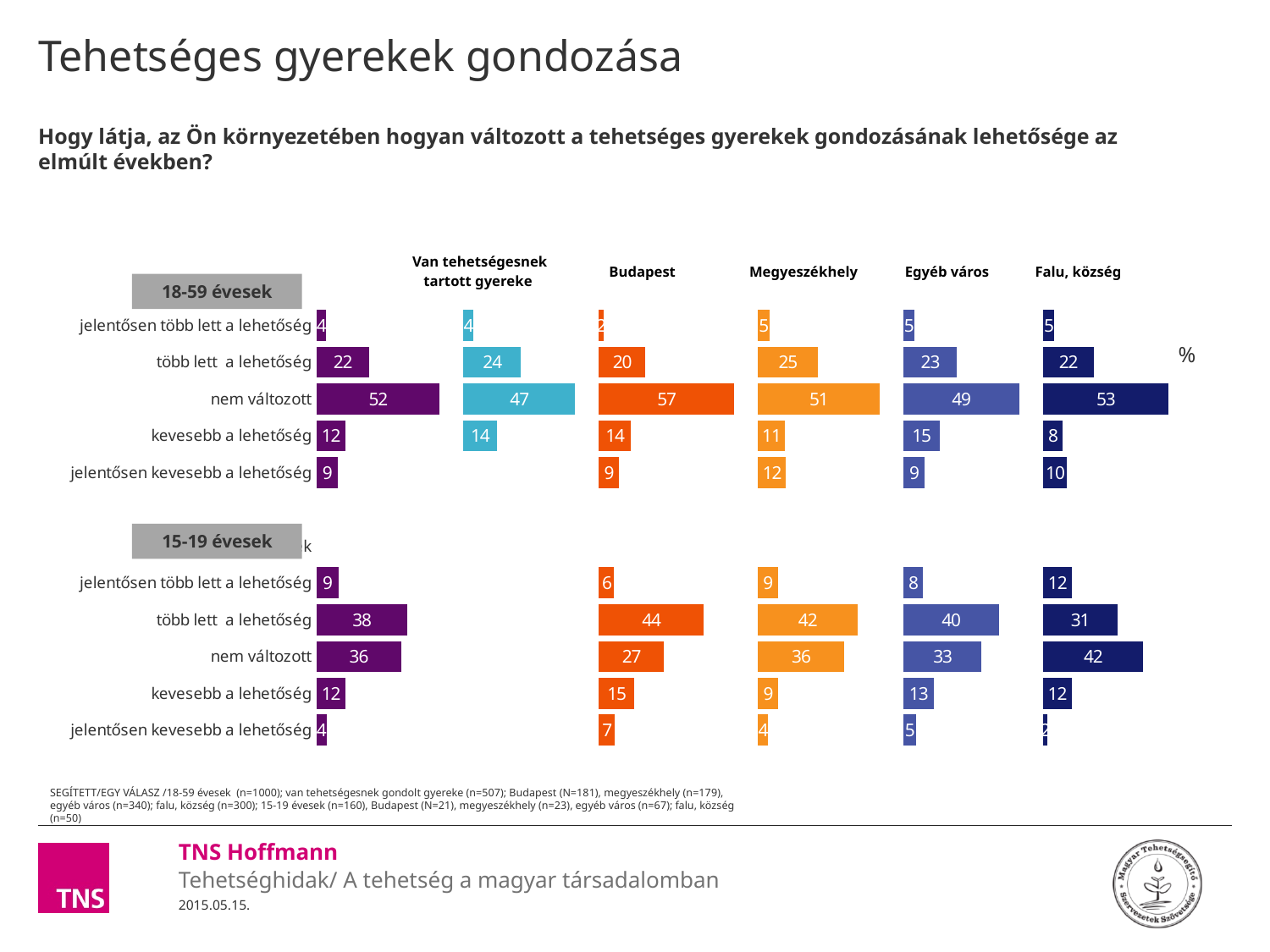
What type of chart is used on this slide? bar chart In the 15-19 évesek chart, which is larger in the Megyeszékhely column: "több lett a lehetőség" or "nem változott"? több lett a lehetőség In the 18-59 évesek chart, what is the value for "nem változott" in the Budapest column? 57 How many response categories are listed in the 18-59 évesek chart? 5 In the 18-59 évesek chart, what is the value for "kevesebb a lehetőség" in the Van tehetségesnek tartott gyereke column? 14 In the 15-19 évesek chart, what is the value for "több lett a lehetőség" in the Falu, község column? 31 In the 15-19 évesek chart, what is the difference between "nem változott" in the Falu, község column (42) and in the Budapest column (27)? 15 In the 18-59 évesek chart, what is the difference between "nem változott" in the Budapest column (57) and in the Van tehetségesnek tartott gyereke column (47)? 10 In the 15-19 évesek chart, which response category has the lowest value in the Budapest column? jelentősen több lett a lehetőség In the 15-19 évesek chart, what is the value for "jelentősen több lett a lehetőség" in the Egyéb város column? 8 Which column heading appears in the 18-59 évesek chart but not in the 15-19 évesek chart? Van tehetségesnek tartott gyereke In the 18-59 évesek chart, which response category has the highest value in the Falu, község column? nem változott